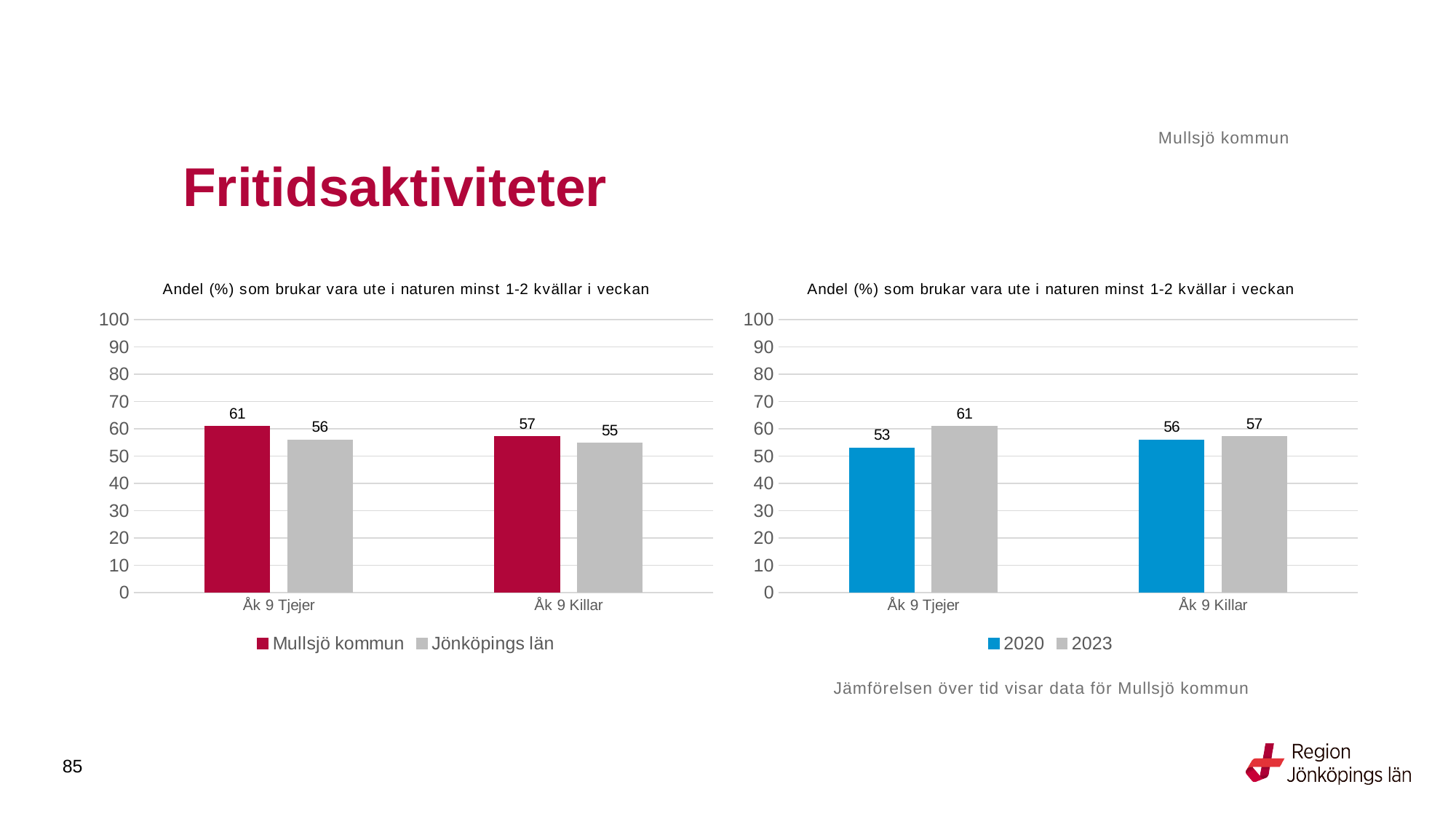
In the left chart, what is the value for Mullsjö kommun for Åk 9 Tjejer? 61 In the left chart, which is larger for Åk 9 Killar: Mullsjö kommun or Jönköpings län? Mullsjö kommun In the left chart, what is the value for Jönköpings län for Åk 9 Killar? 55 In the left chart, what is the difference between Mullsjö kommun and Jönköpings län for Åk 9 Tjejer? 5 In the right chart, what is the difference between 2023 and 2020 for Åk 9 Tjejer? 8 In the right chart, which bar has the lowest value? 2020 for Åk 9 Tjejer In the right chart, what is the value for 2023 for Åk 9 Killar? 57 In the right chart, what is the value for 2020 for Åk 9 Tjejer? 53 How many series does the legend of the right chart list? 2 In the right chart, which year has the higher value for Åk 9 Tjejer? 2023 What kind of chart is the left chart? Bar chart What are the two series named in the legend of the left chart? Mullsjö kommun and Jönköpings län